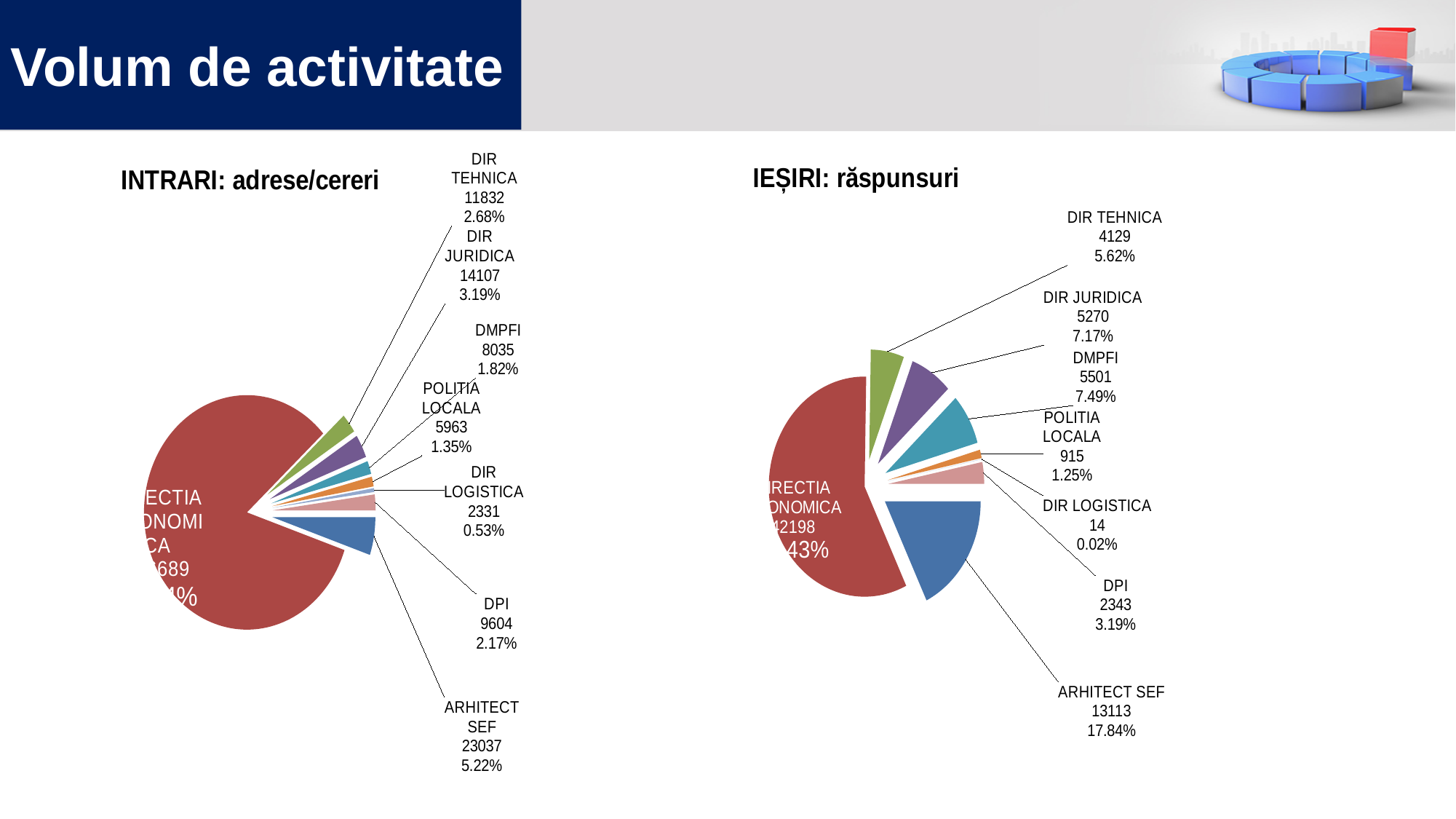
In the IEȘIRI: răspunsuri chart, which category has the largest slice? DIRECTIA ECONOMICA In the IEȘIRI: răspunsuri chart, what percentage share is shown for ARHITECT SEF? 17.84% In the INTRARI: adrese/cereri chart, which category has the smallest value? DIR LOGISTICA In the INTRARI: adrese/cereri chart, what percentage share is shown for DIR JURIDICA? 3.19% How many slices does the IEȘIRI: răspunsuri chart have? 8 In the INTRARI: adrese/cereri chart, what value is shown for ARHITECT SEF? 23037 In the INTRARI: adrese/cereri chart, what is the difference between the values for DIR JURIDICA and DIR TEHNICA? 2275 In the IEȘIRI: răspunsuri chart, what value is shown for DMPFI? 5501 In the IEȘIRI: răspunsuri chart, which category has the smallest value? DIR LOGISTICA In the IEȘIRI: răspunsuri chart, what is the difference between the values for DPI and POLITIA LOCALA? 1428 In the IEȘIRI: răspunsuri chart, which is larger, the value for DIR JURIDICA or the value for DIR TEHNICA? DIR JURIDICA What kind of chart is the INTRARI: adrese/cereri chart? Pie chart